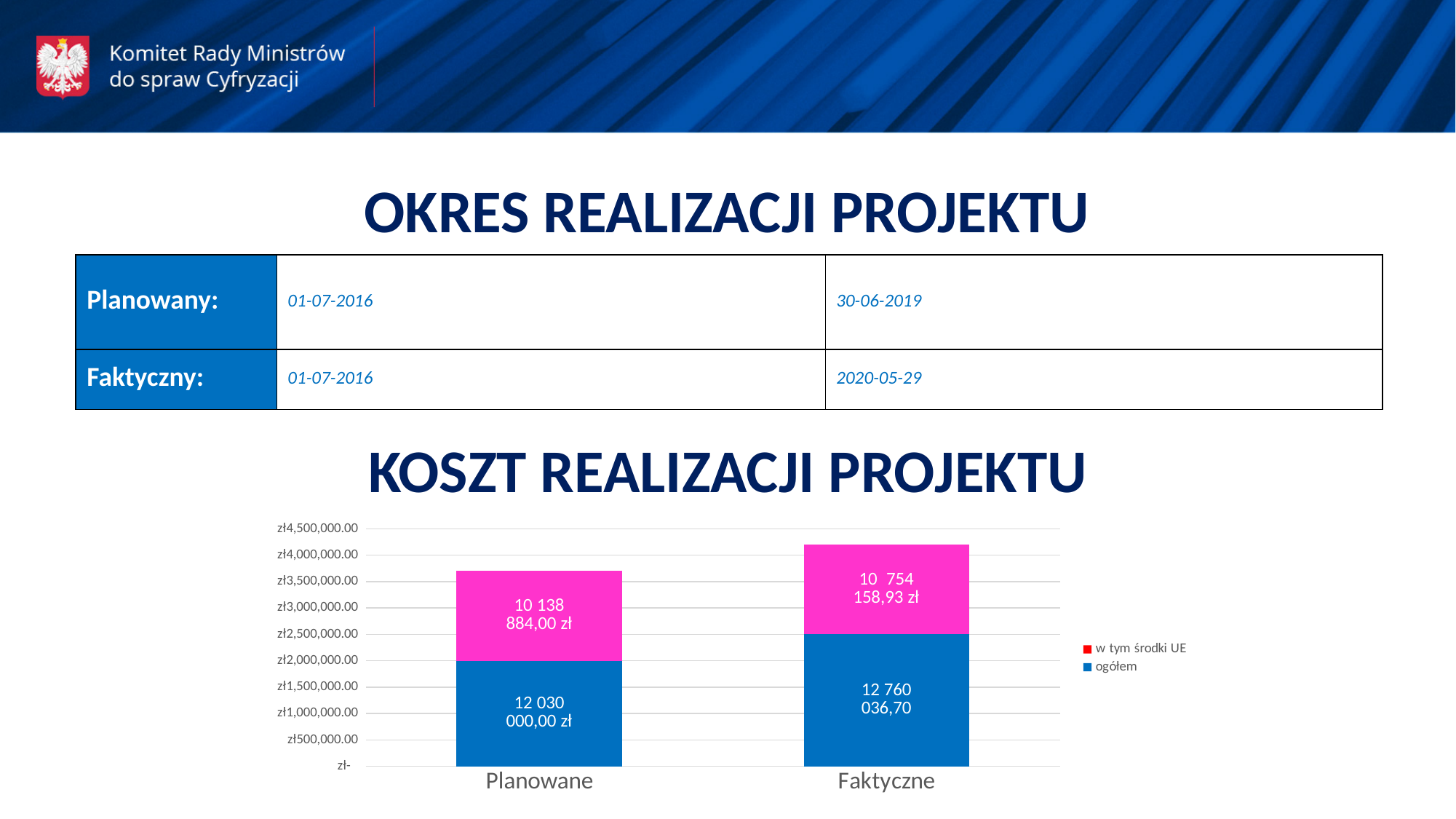
How many categories are shown on the x axis of the KOSZT REALIZACJI PROJEKTU chart? 2 In the KOSZT REALIZACJI PROJEKTU chart, what is the value labelled on the w tym środki UE segment for Planowane? 10 138 884,00 zł In the KOSZT REALIZACJI PROJEKTU chart, what is the value labelled on the w tym środki UE segment for Faktyczne? 10 754 158,93 zł In the KOSZT REALIZACJI PROJEKTU chart, what is the value labelled on the ogółem segment for Faktyczne? 12 760 036,70 In the KOSZT REALIZACJI PROJEKTU chart, is the top of the Faktyczne stacked bar greater or less than zł4,000,000.00? greater What type of chart is shown under the title KOSZT REALIZACJI PROJEKTU? stacked bar chart In the KOSZT REALIZACJI PROJEKTU chart, which category has the taller stacked bar, Planowane or Faktyczne? Faktyczne In the KOSZT REALIZACJI PROJEKTU chart, which series is shown in red/magenta according to the legend? w tym środki UE In the KOSZT REALIZACJI PROJEKTU chart, which series is shown in blue according to the legend? ogółem How many series does the legend of the KOSZT REALIZACJI PROJEKTU chart list? 2 In the KOSZT REALIZACJI PROJEKTU chart, is the top of the Planowane stacked bar greater or less than zł3,500,000.00? greater In the KOSZT REALIZACJI PROJEKTU chart, what is the value labelled on the ogółem segment for Planowane? 12 030 000,00 zł